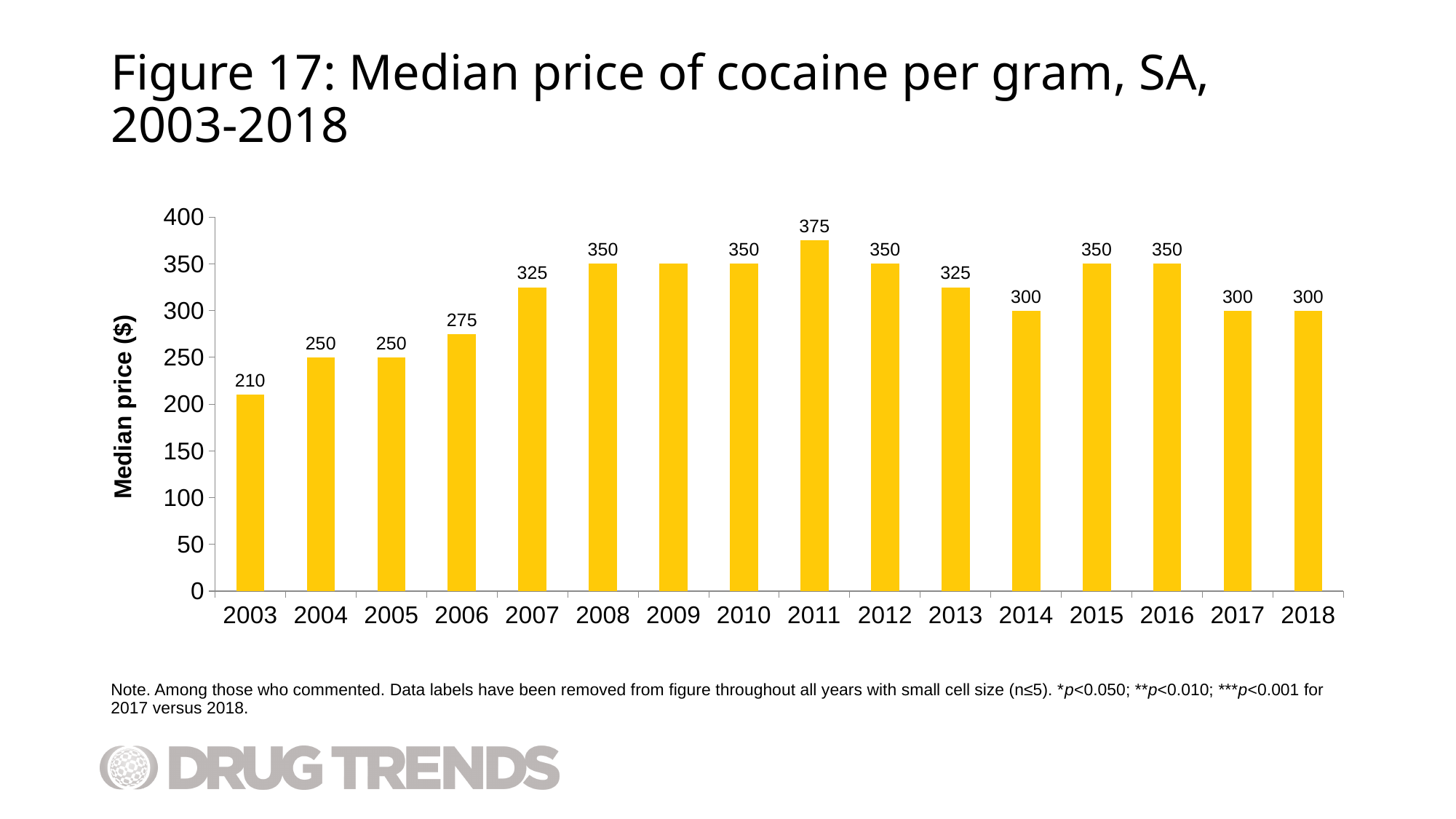
Which year has the lowest median price of cocaine per gram? 2003 What is the median price of cocaine per gram in 2011? 375 Is the value for 2009 greater or less than 300? greater What is the label of the vertical axis? Median price ($) What is the difference between the median price in 2008 and the median price in 2006? 75 What is the median price of cocaine per gram in 2003? 210 Which year has a higher median price, 2007 or 2014? 2007 What kind of chart is shown on the slide? Bar chart What is the difference between the median price in 2011 and the median price in 2003? 165 What is the median price of cocaine per gram in 2018? 300 Which year has the highest median price of cocaine per gram? 2011 How many years are shown on the x axis of the chart? 16